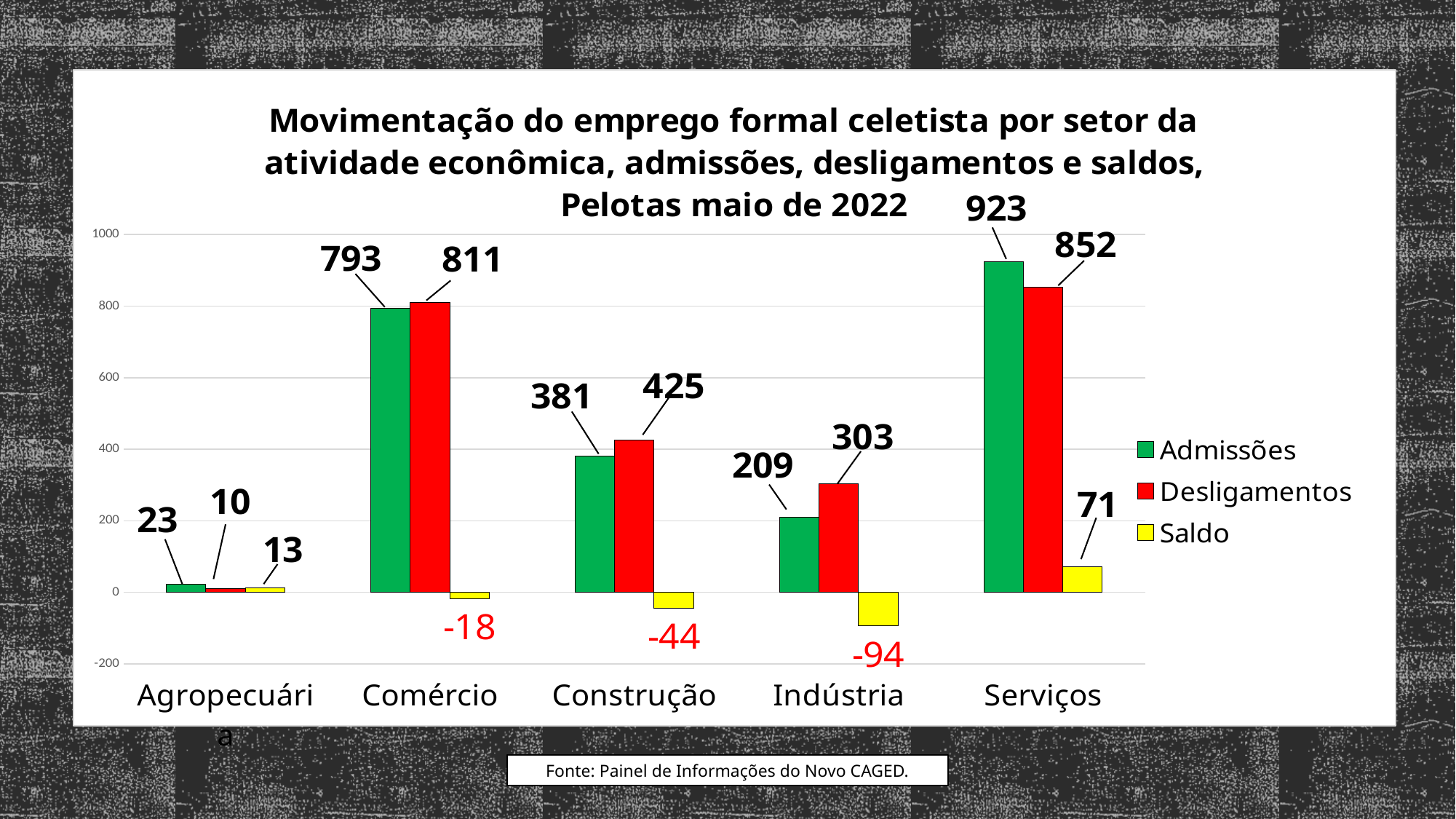
Which sector has the lowest Desligamentos value? Agropecuária How many sectors are shown on the x axis? 5 What kind of chart is shown on the slide? Bar chart Which is larger for Indústria, Admissões or Desligamentos? Desligamentos How many series does the legend list? 3 What is the difference between Desligamentos and Admissões for Construção? 44 Which sector has the highest Admissões value? Serviços What is the Saldo value for Indústria? -94 Which colour represents the Saldo series? Yellow What is the value of Desligamentos for Serviços? 852 What is the value of Admissões for Comércio? 793 What is the Saldo value for Serviços? 71